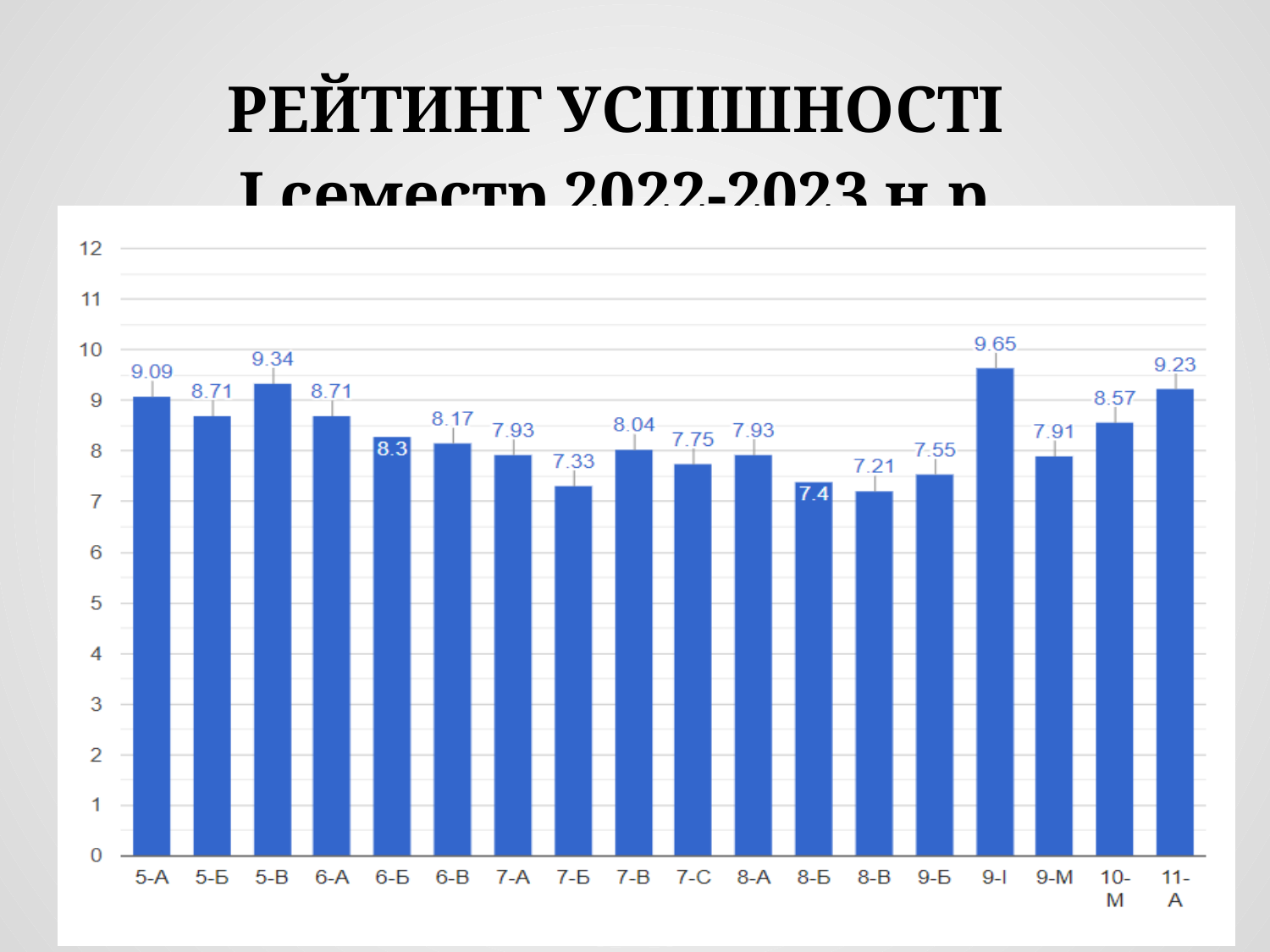
How many categories are shown on the x axis? 18 Which category has the lowest value? 8-В What is the difference between the values for 6-Б and 6-В? 0.13 What is the value for 5-В? 9.34 What is the value for 8-В? 7.21 Which is larger, the value for 5-А or the value for 11-А? 11-А What is the maximum value shown on the y axis? 12 Which category has the highest value? 9-І Is the value for 7-Б greater or less than 8? less What kind of chart is shown on the slide? bar chart What is the value for 10-М? 8.57 What is the difference between the values for 9-І and 8-В? 2.44